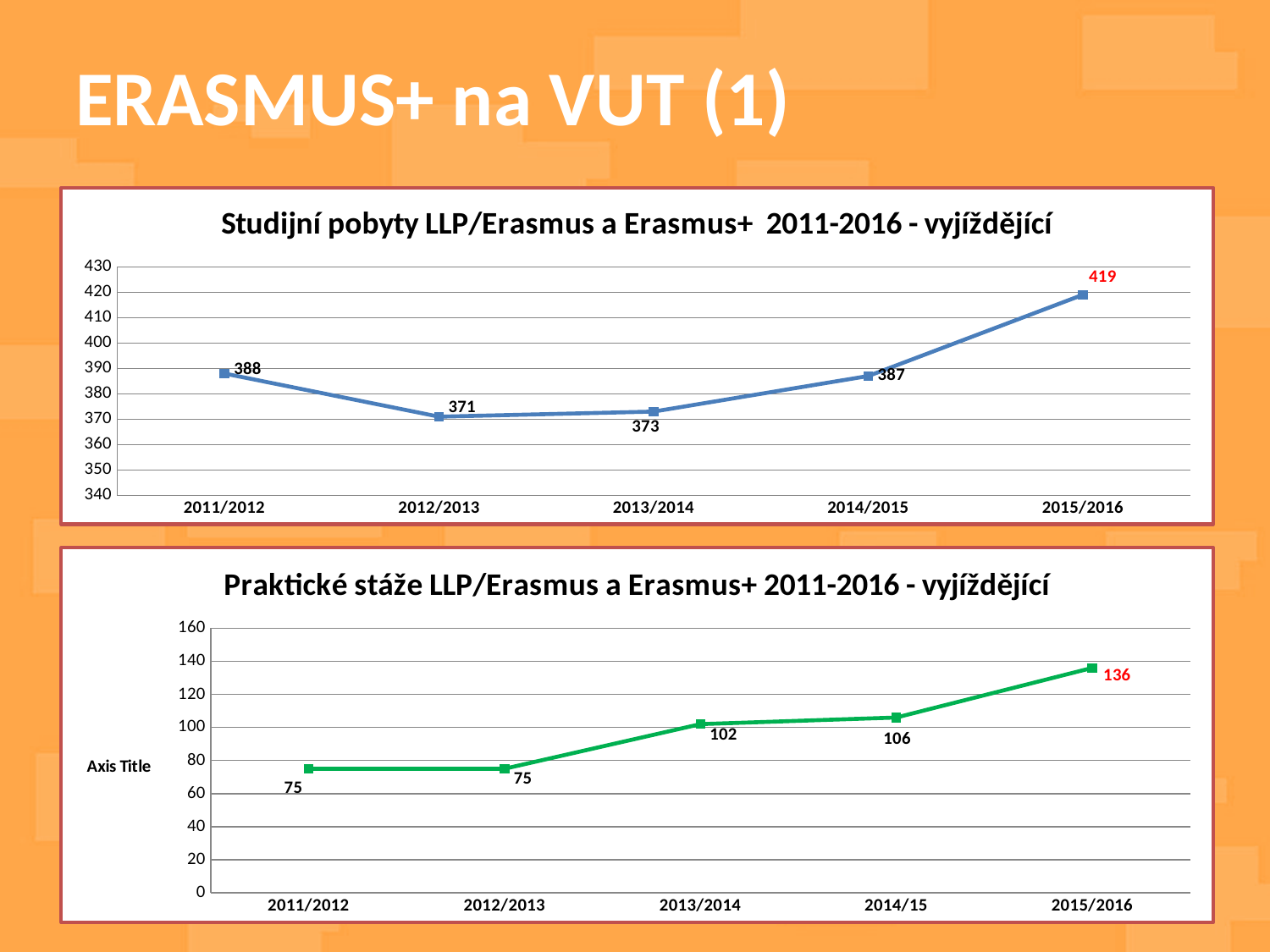
In the top chart (Studijní pobyty), how many data points are plotted? 5 In the top chart (Studijní pobyty), what is the value for 2015/2016? 419 In the top chart (Studijní pobyty), which year has the lowest value? 2012/2013 In the top chart (Studijní pobyty), which is larger, the value for 2011/2012 or the value for 2014/2015? 2011/2012 What kind of chart is the top chart (Studijní pobyty)? line chart What is the title of the bottom chart? Praktické stáže LLP/Erasmus a Erasmus+ 2011-2016 - vyjíždějící In the bottom chart (Praktické stáže), which year has the highest value? 2015/2016 In the bottom chart (Praktické stáže), is the value for 2015/2016 greater or less than 120? greater In the bottom chart (Praktické stáže), what is the value for 2014/15? 106 In the bottom chart (Praktické stáže), what is the difference between the values for 2013/2014 and 2012/2013? 27 In the bottom chart (Praktické stáže), do the values rise or fall from 2012/2013 to 2015/2016? rise In the top chart (Studijní pobyty), what is the difference between the values for 2015/2016 and 2011/2012? 31